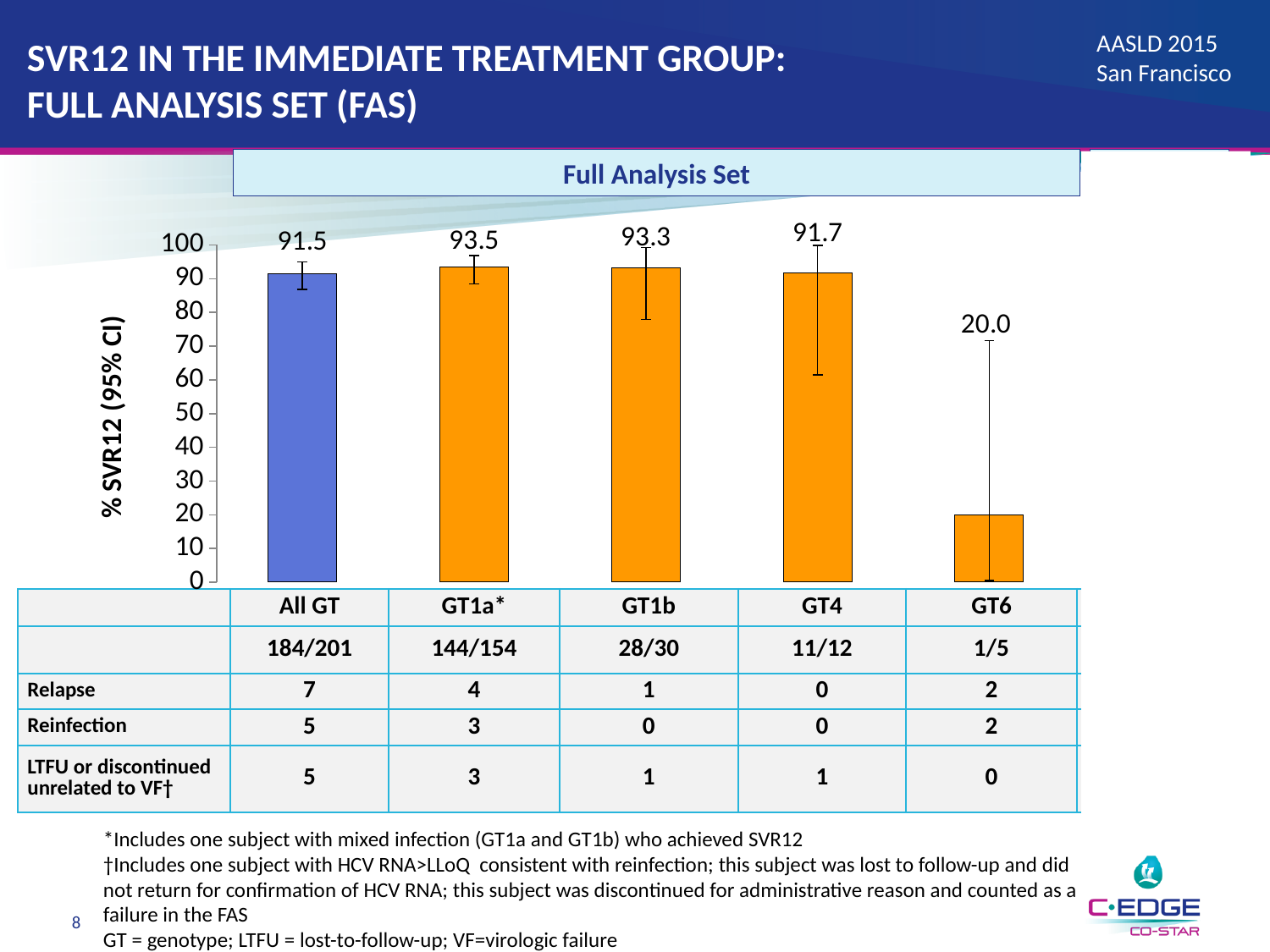
Which genotype category has the lowest % SVR12? GT6 What is the label of the y axis of the chart? % SVR12 (95% CI) What is the difference in % SVR12 between GT1b and GT6? 73.3 Which bar is coloured differently (blue) from the other orange bars? All GT What kind of chart is used to show % SVR12? bar chart What is the % SVR12 value for GT6? 20.0 Which has a higher % SVR12, GT4 or GT1b? GT1b What is the % SVR12 value for All GT? 91.5 How many genotype categories are shown on the x axis of the chart? 5 Is the % SVR12 value for GT6 greater or less than 30? less Which genotype category has the highest % SVR12? GT1a* What is the % SVR12 value for GT1a*? 93.5